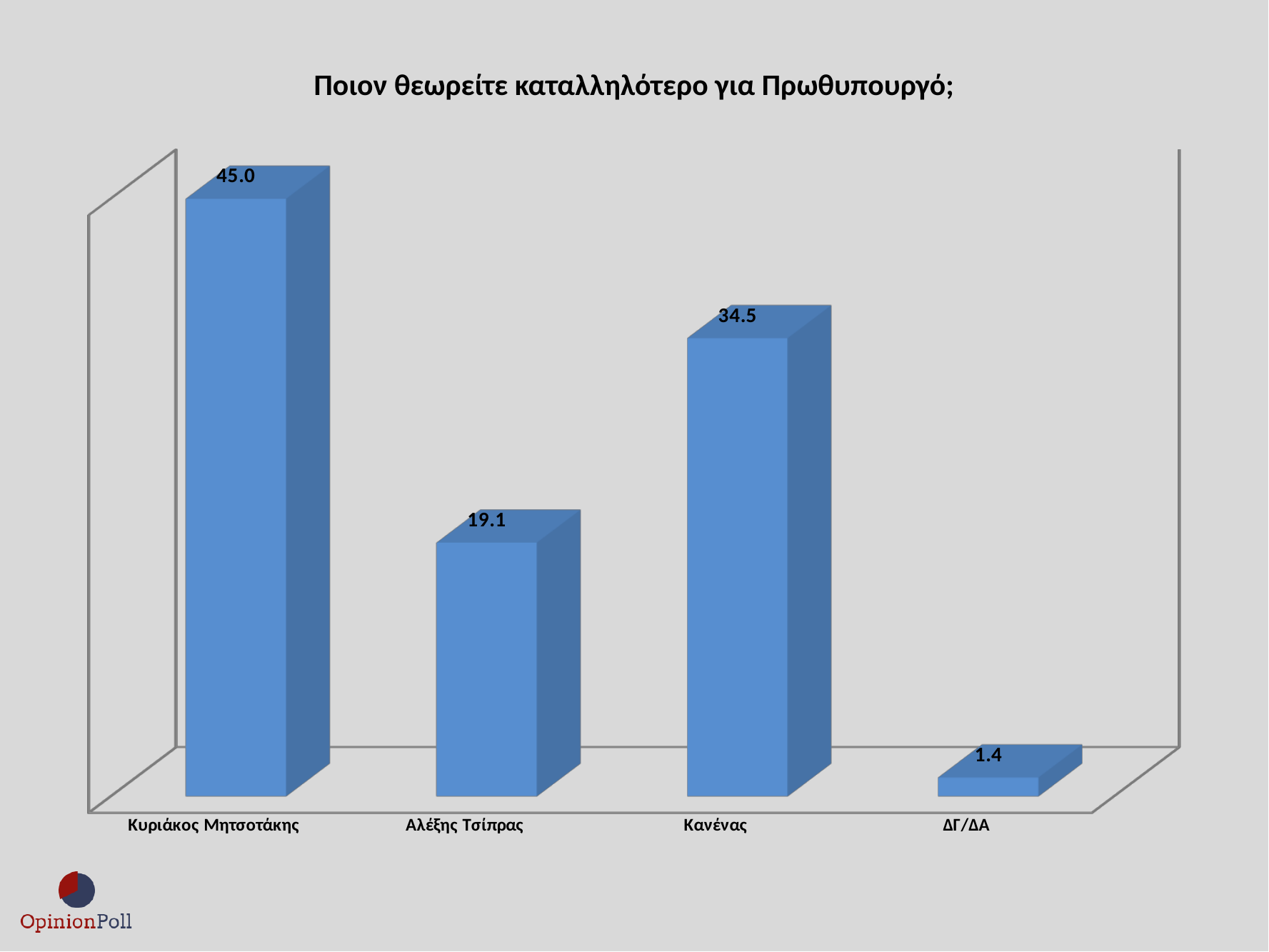
What is the title of the chart? Ποιον θεωρείτε καταλληλότερο για Πρωθυπουργό; What is the value for Κυριάκος Μητσοτάκης? 45.0 What is the value for ΔΓ/ΔΑ? 1.4 Which is larger, the value for Κανένας or the value for Αλέξης Τσίπρας? Κανένας What is the value for Αλέξης Τσίπρας? 19.1 What is the difference between the values for Κυριάκος Μητσοτάκης and Αλέξης Τσίπρας? 25.9 Which category has the lowest value? ΔΓ/ΔΑ Which category has the highest value? Κυριάκος Μητσοτάκης What kind of chart is shown on the slide? Bar chart How many categories are shown in the chart? 4 What is the value for Κανένας? 34.5 What is the difference between the values for Κανένας and Αλέξης Τσίπρας? 15.4